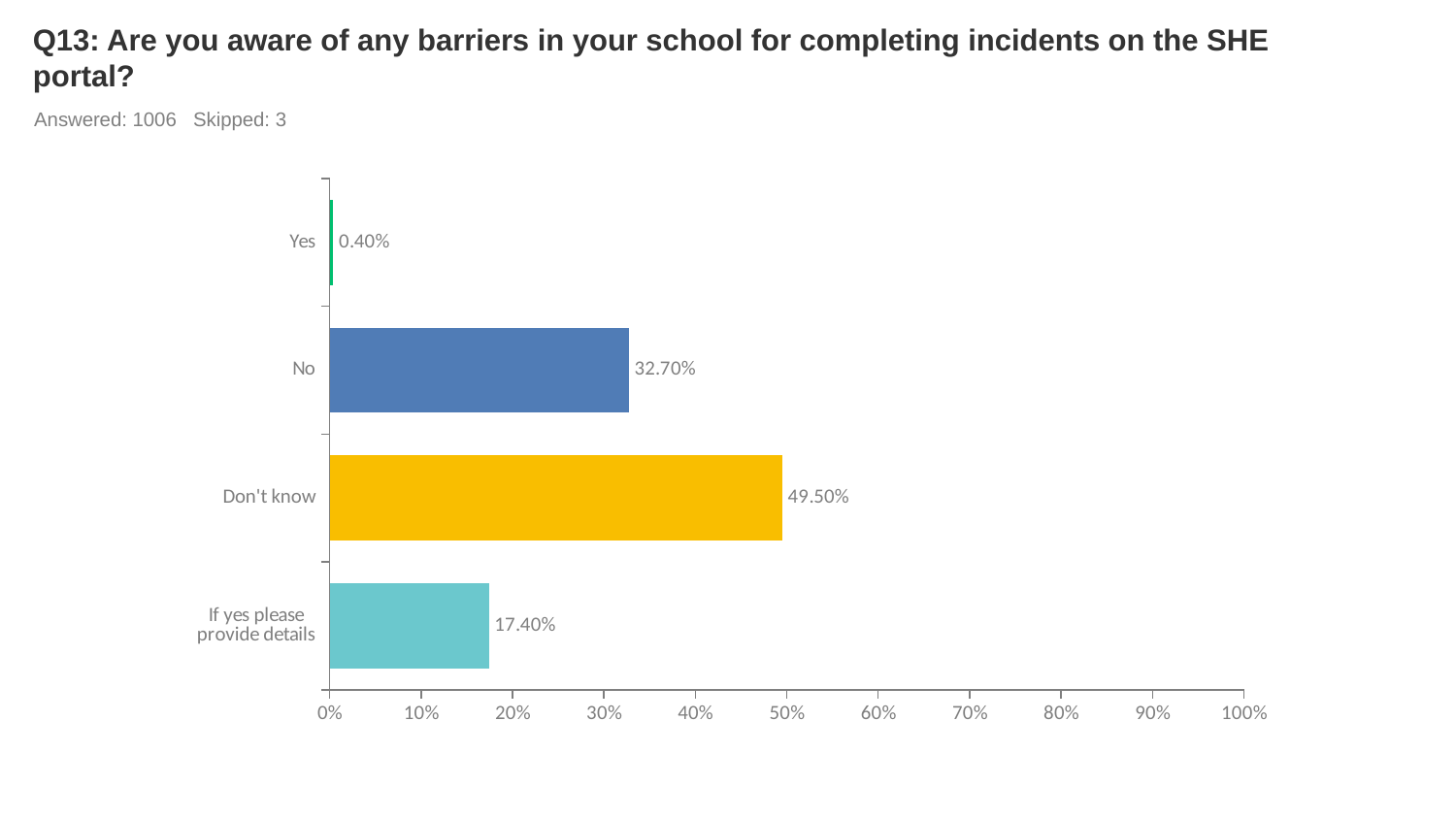
How many respondents answered this question according to the slide? 1006 What is the difference between the values for "Don't know" and "No"? 16.80% What kind of chart is shown on the slide? Bar chart What percentage of respondents answered "Don't know"? 49.50% What is the value shown for "Yes"? 0.40% Which is larger, the value for "No" or the value for "If yes please provide details"? No Which response category has the lowest value? Yes What is the value shown for "No"? 32.70% Is the value for "Don't know" greater or less than 40%? greater What is the value shown for "If yes please provide details"? 17.40% How many response categories are shown in the chart? 4 Which response category has the highest value? Don't know